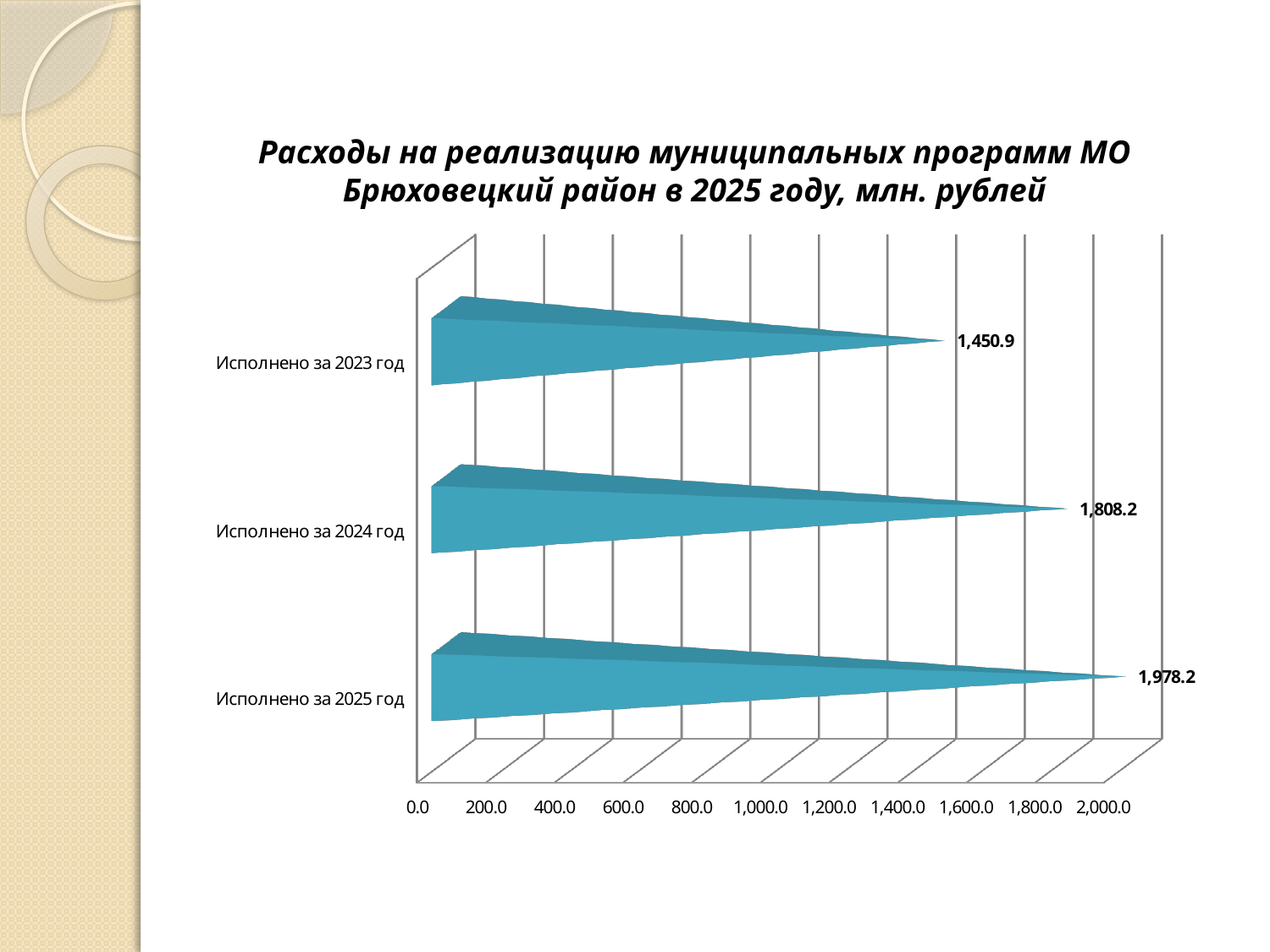
Which is larger: the value for «Исполнено за 2024 год» or for «Исполнено за 2025 год»? Исполнено за 2025 год How many categories are shown in the chart? 3 What is the difference between the values for «Исполнено за 2024 год» and «Исполнено за 2023 год»? 357.3 What kind of chart is shown on the slide? bar chart Is the value for «Исполнено за 2023 год» greater or less than 1,600.0? less What is the value for «Исполнено за 2024 год»? 1,808.2 Which category has the lowest value? Исполнено за 2023 год What is the difference between the values for «Исполнено за 2025 год» and «Исполнено за 2023 год»? 527.3 Do the values rise or fall from «Исполнено за 2023 год» to «Исполнено за 2025 год»? rise Which category has the highest value? Исполнено за 2025 год What is the value for «Исполнено за 2023 год»? 1,450.9 What is the value for «Исполнено за 2025 год»? 1,978.2